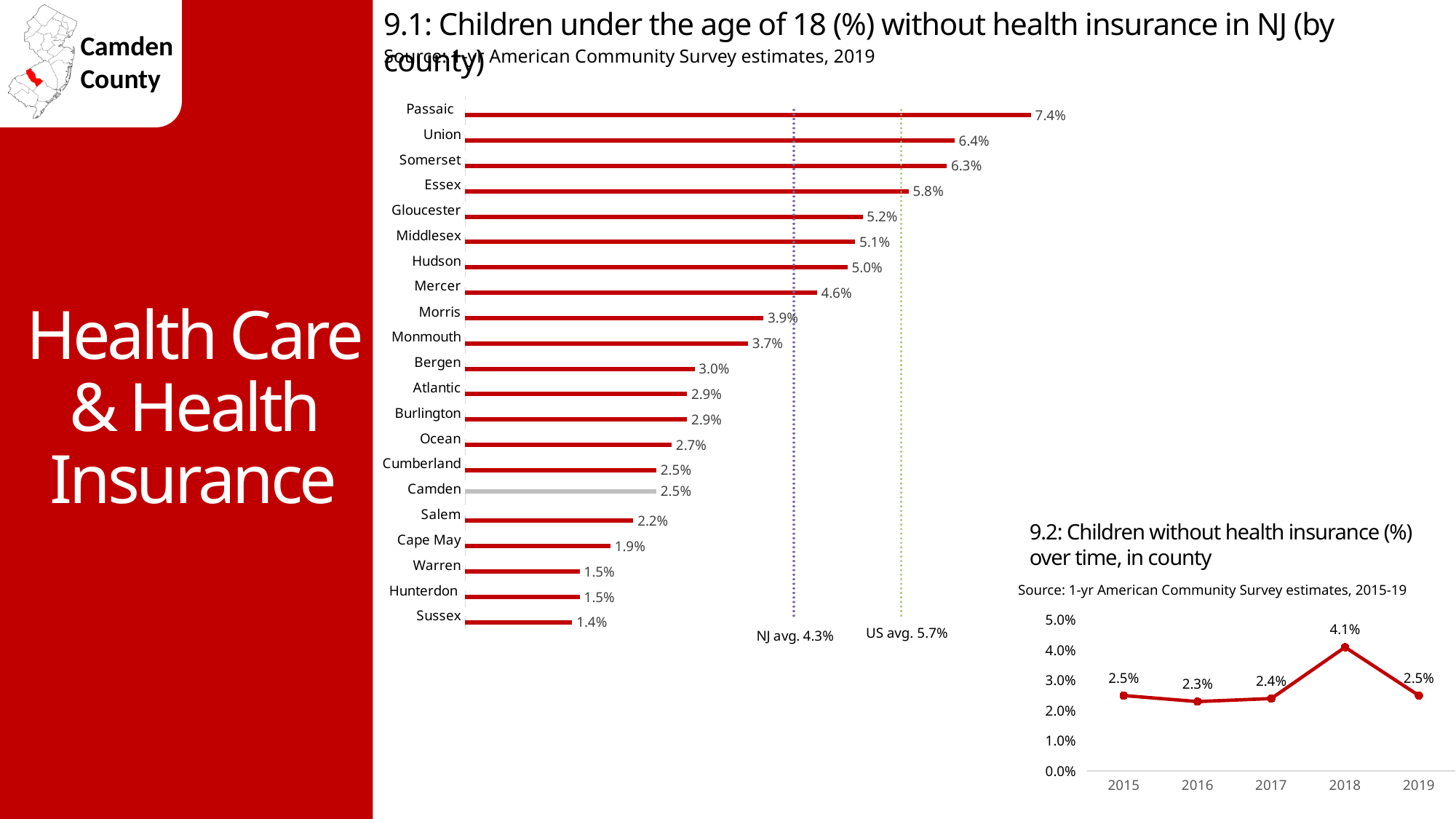
In chart 9.1 (children under 18 without health insurance by county), what is the value for Passaic? 7.4% In chart 9.1, what is the NJ average shown by the dotted reference line? 4.3% In chart 9.1, how many counties are plotted? 21 In chart 9.1, which county has a larger value, Mercer or Morris? Mercer In chart 9.2 (children without health insurance over time in county), what is the value for 2018? 4.1% In chart 9.1, which county has the lowest percentage of children without health insurance? Sussex In chart 9.1, what is the value for Camden? 2.5% In chart 9.2, which year has the highest value? 2018 What type of chart is chart 9.1? Bar chart In chart 9.2, what is the difference between the values for 2018 and 2019? 1.6% In chart 9.1, which county has the highest percentage of children without health insurance? Passaic In chart 9.1, what is the difference between the values for Union and Essex? 0.6%